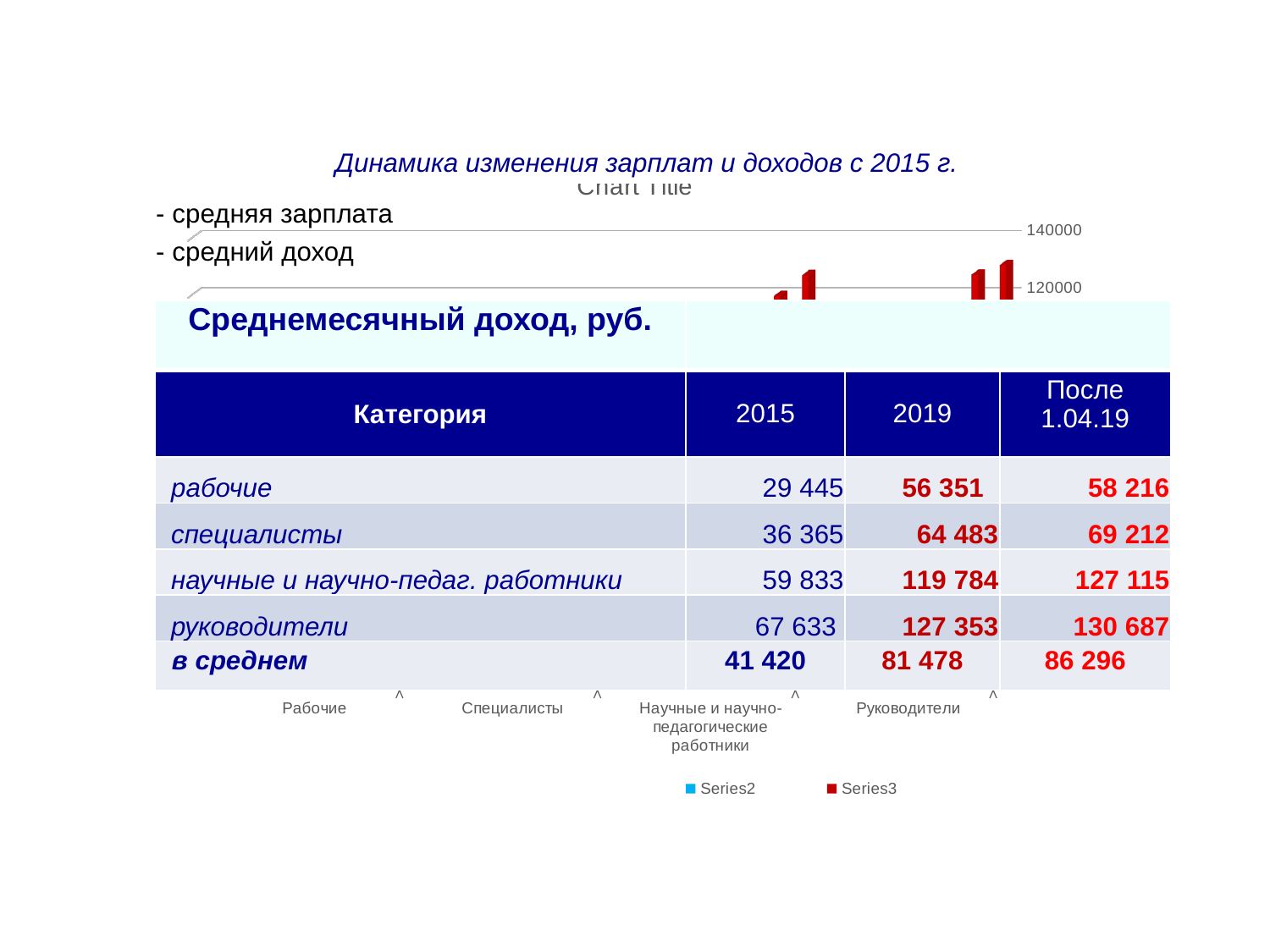
Is the Series3 value for Руководители greater or less than 140000? less What is the title shown above the chart? Chart Title How many series does the chart's legend list? 2 Is the Series3 value for Научные и научно-педагогические работники greater or less than 140000? less What kind of chart is shown on the slide? bar chart What are the entries in the chart's legend? Series2, Series3 How many categories are shown along the x axis of the chart? 4 Which category label appears first (leftmost) on the chart's x axis? Рабочие